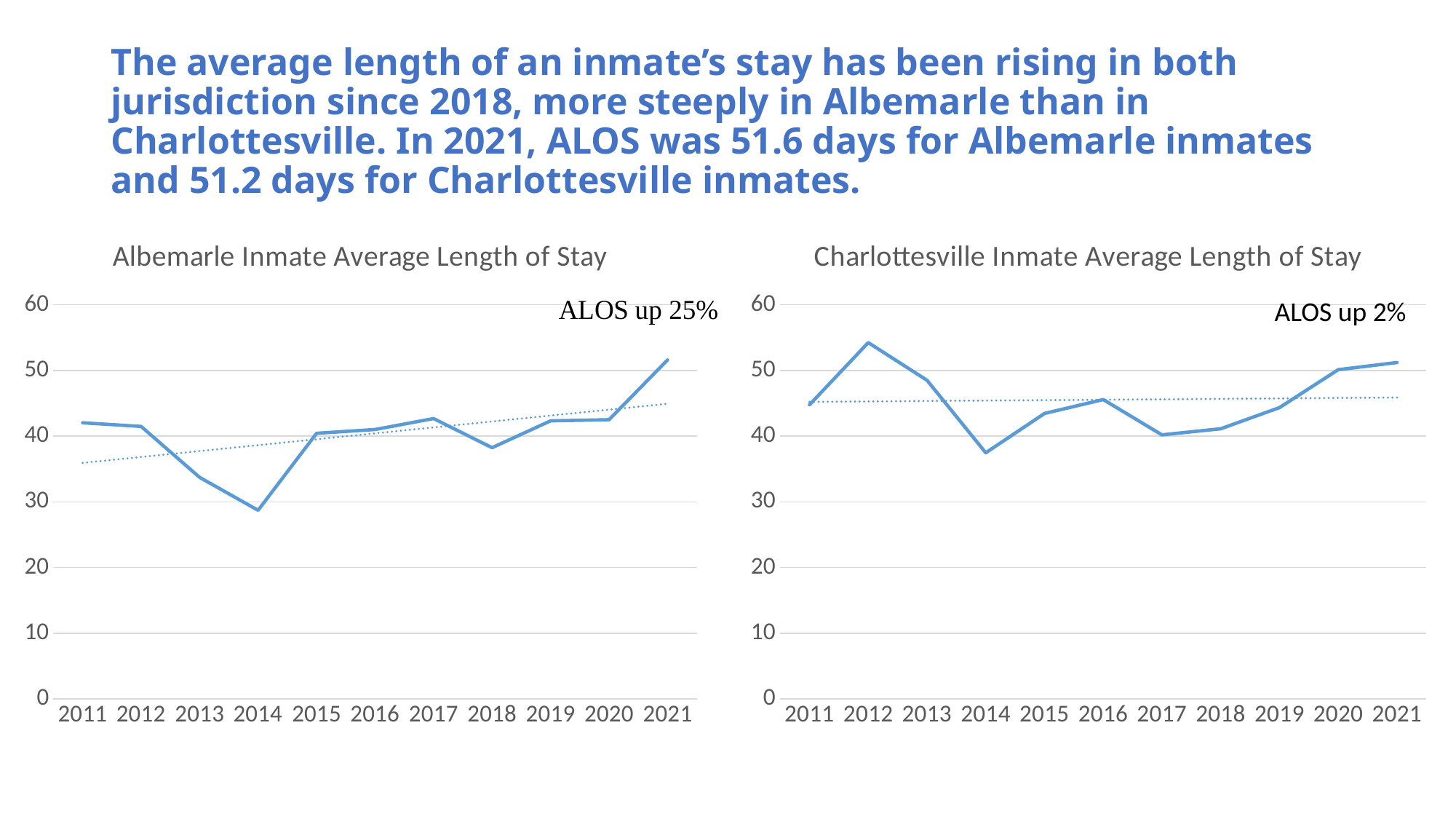
In the Charlottesville Inmate Average Length of Stay chart, is the value for 2014 greater or less than 40? less In the Albemarle Inmate Average Length of Stay chart, which year has the highest value? 2021 In the Charlottesville Inmate Average Length of Stay chart, what was the average length of stay in 2021? 51.2 days How many years are plotted on the x axis of the Charlottesville Inmate Average Length of Stay chart? 11 In the Charlottesville Inmate Average Length of Stay chart, which year has the highest value? 2012 What type of chart is the Albemarle Inmate Average Length of Stay chart? line chart In the Albemarle Inmate Average Length of Stay chart, what was the average length of stay in 2021? 51.6 days In the Albemarle Inmate Average Length of Stay chart, do values rise or fall from 2018 to 2021? rise What is the difference between the 2021 average length of stay for Albemarle inmates and for Charlottesville inmates? 0.4 days In the Charlottesville Inmate Average Length of Stay chart, which year has the lowest value? 2014 In the Albemarle Inmate Average Length of Stay chart, is the value for 2018 greater or less than 40? less In the Albemarle Inmate Average Length of Stay chart, which year has the lowest value? 2014